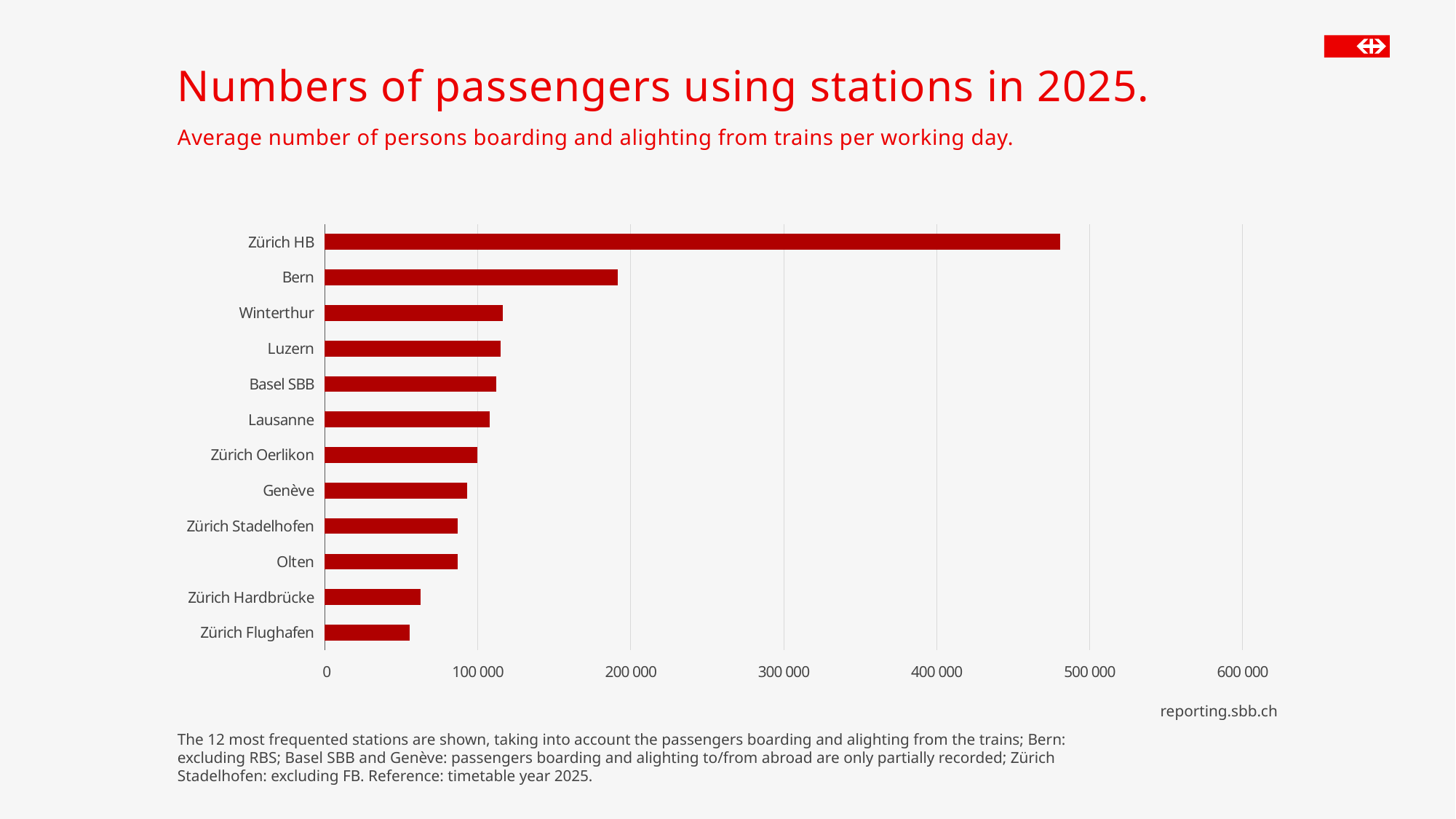
Which has more passengers, Bern or Winterthur? Bern How many stations are shown in the chart? 12 Which has more passengers, Genève or Zürich Hardbrücke? Genève Is the value for Zürich Flughafen greater or less than 100 000? less Which station has the lowest number of passengers? Zürich Flughafen Is the value for Genève greater or less than 100 000? less Is the value for Zürich HB greater or less than 400 000? greater What is the title of the chart on the slide? Numbers of passengers using stations in 2025. What kind of chart is shown on the slide? bar chart Which station has the highest number of passengers? Zürich HB